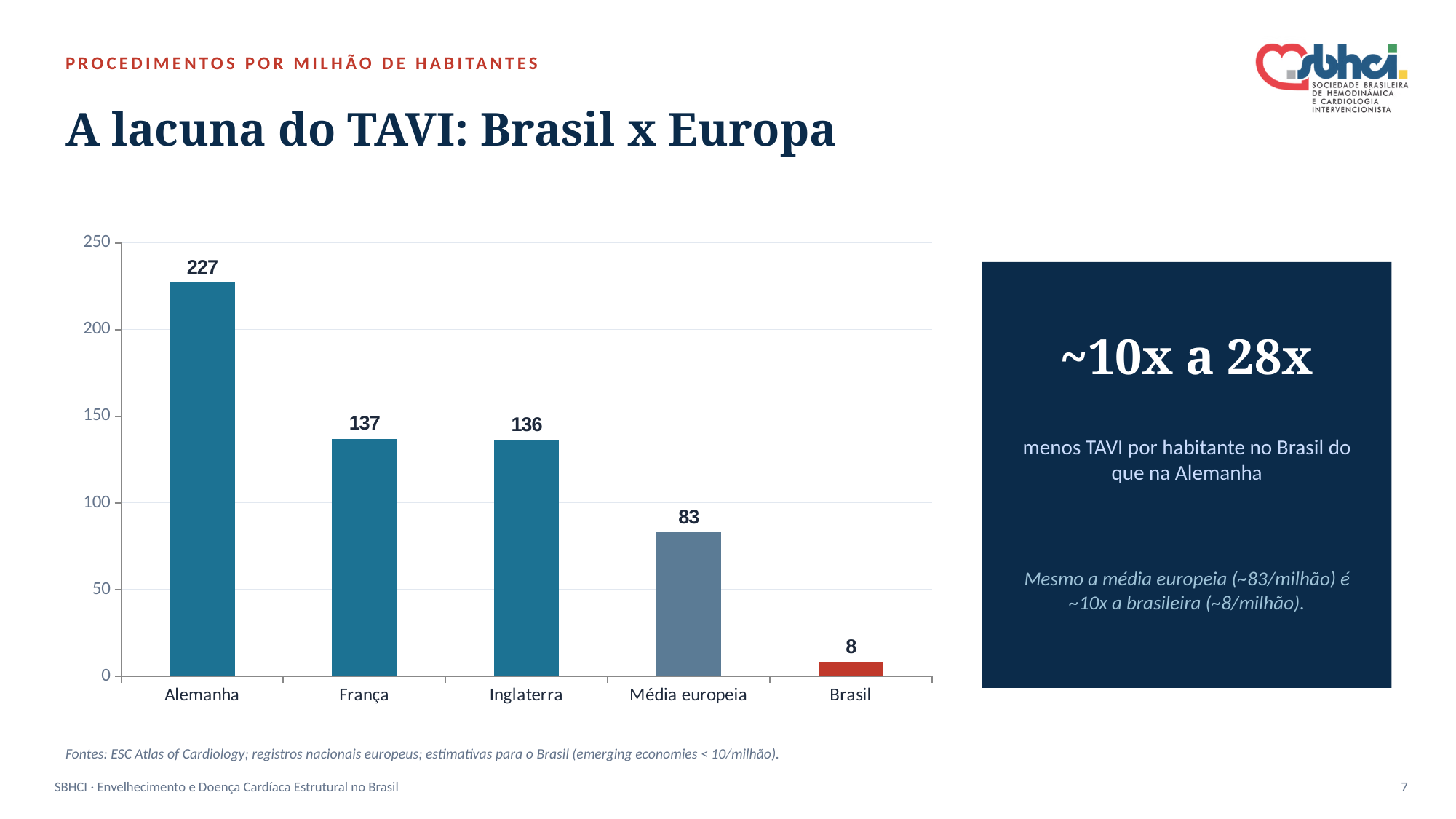
What kind of chart is shown on the slide? bar chart What is the difference between the values for França and Média europeia? 54 What is the value for Alemanha? 227 Which category has the highest value? Alemanha How many categories are shown on the x axis? 5 What is the difference between the values for Alemanha and Brasil? 219 Which category has the lowest value? Brasil What is the value for Média europeia? 83 Which is larger, the value for Inglaterra or the value for Média europeia? Inglaterra Which bar is drawn in red? Brasil Is the value for Alemanha greater or less than 200? greater What is the value for Brasil? 8